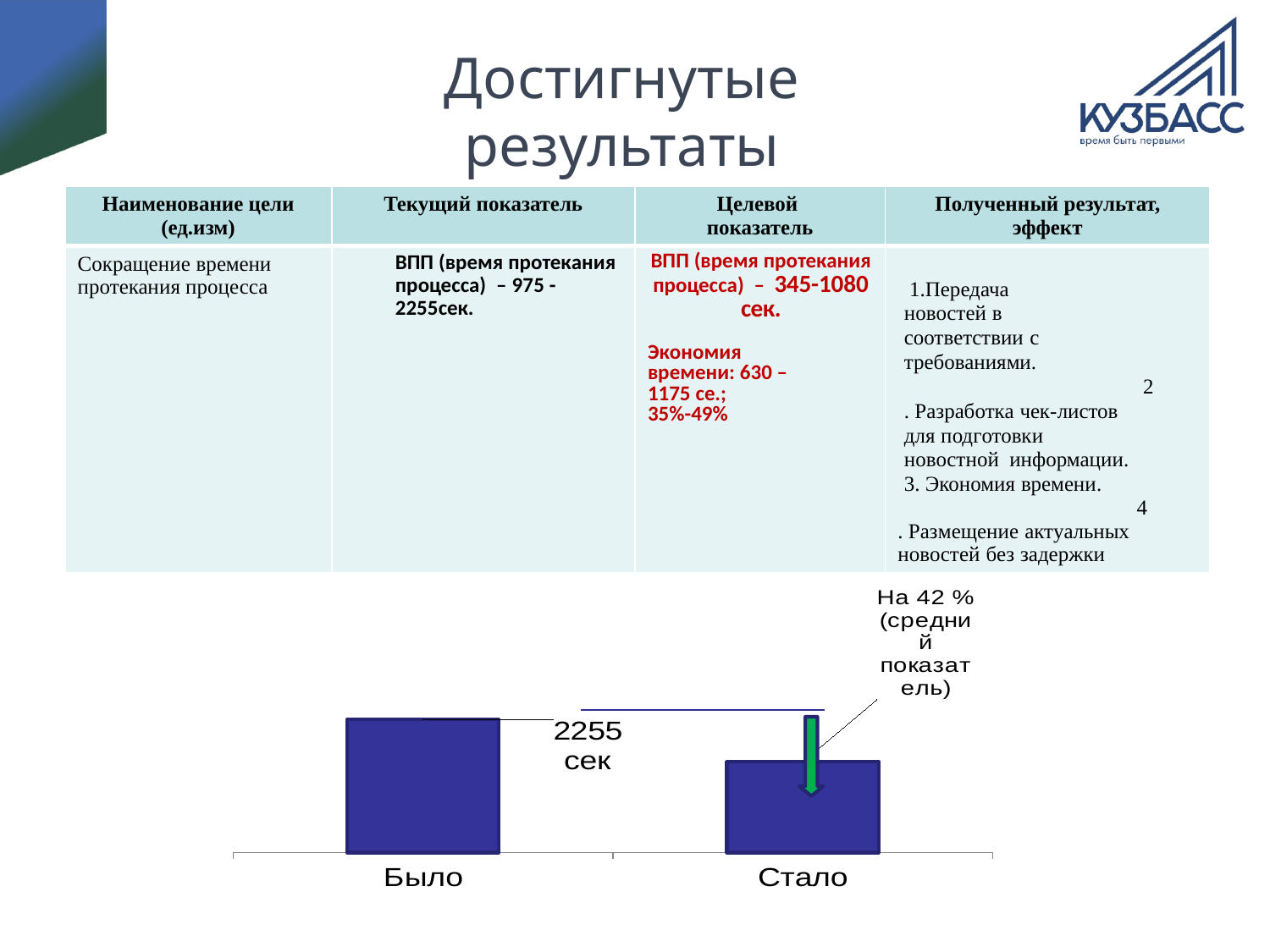
Which bar in the chart is the tallest? Было Which bar in the chart is the shortest? Стало What kind of chart is shown at the bottom of the slide? bar chart What percentage reduction is annotated next to the "Стало" bar in the chart? На 42 % (средний показатель) What are the two category labels on the x axis of the chart? Было, Стало Which bar is taller in the chart, "Было" or "Стало"? Было How many bars does the chart at the bottom of the slide have? 2 What value is labelled on the "Было" bar in the chart? 2255 сек Do the bar values rise or fall from "Было" to "Стало"? fall